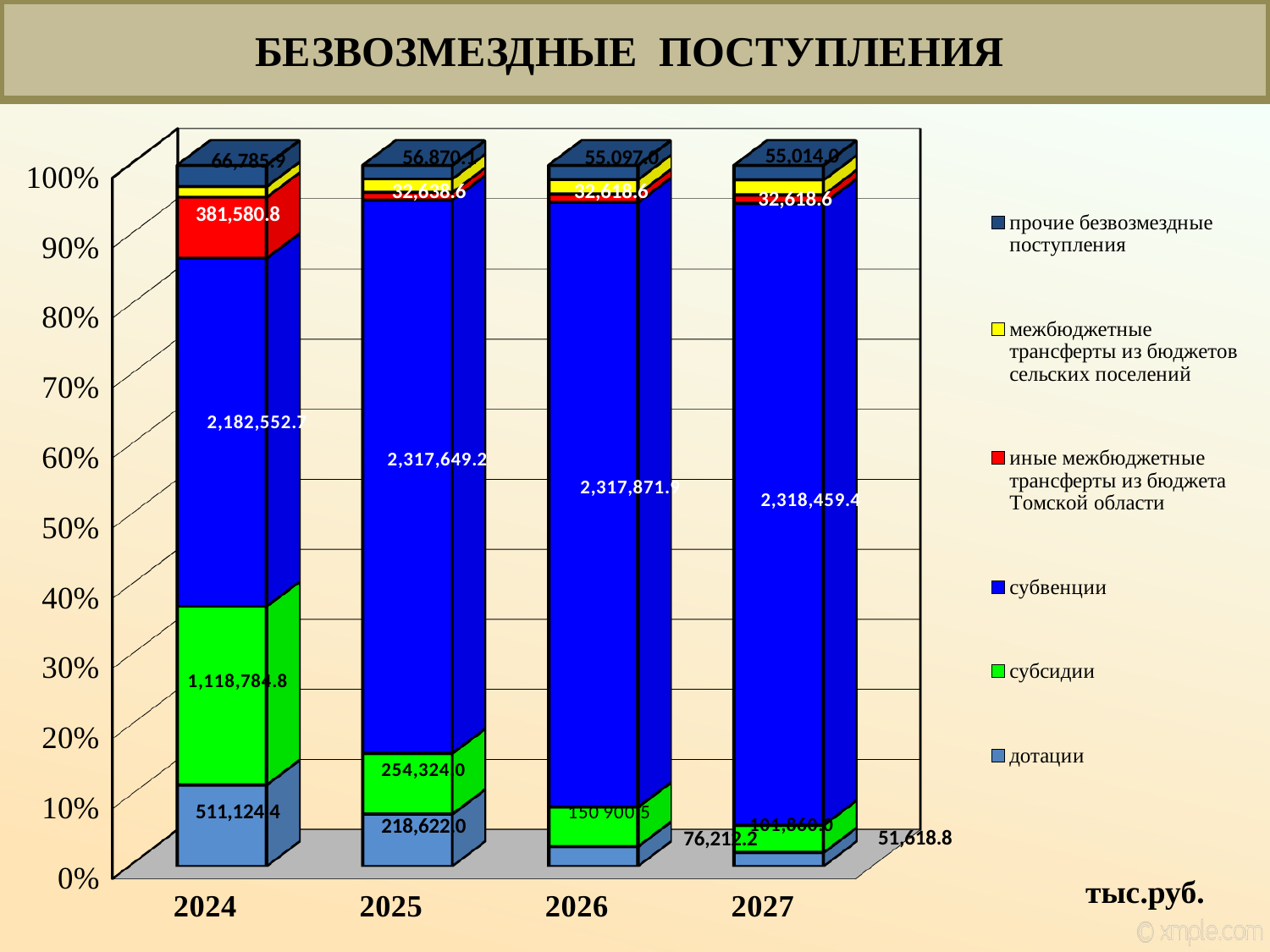
What kind of chart is shown on the slide? stacked bar chart What is the value of субсидии for 2024? 1,118,784.8 What is the value of прочие безвозмездные поступления for 2026? 55,097.0 Which is larger: дотации in 2026 or дотации in 2027? дотации in 2026 Which year has the highest value of дотации? 2024 What is the value of субвенции for 2024? 2,182,552.7 How many series does the legend list? 6 How many years are shown on the x axis? 4 What is the value of дотации for 2025? 218,622.0 What is the value of субвенции for 2027? 2,318,459.4 What is the value of иные межбюджетные трансферты из бюджета Томской области for 2024? 381,580.8 What is the difference between субсидии in 2025 and субсидии in 2026? 103,423.5